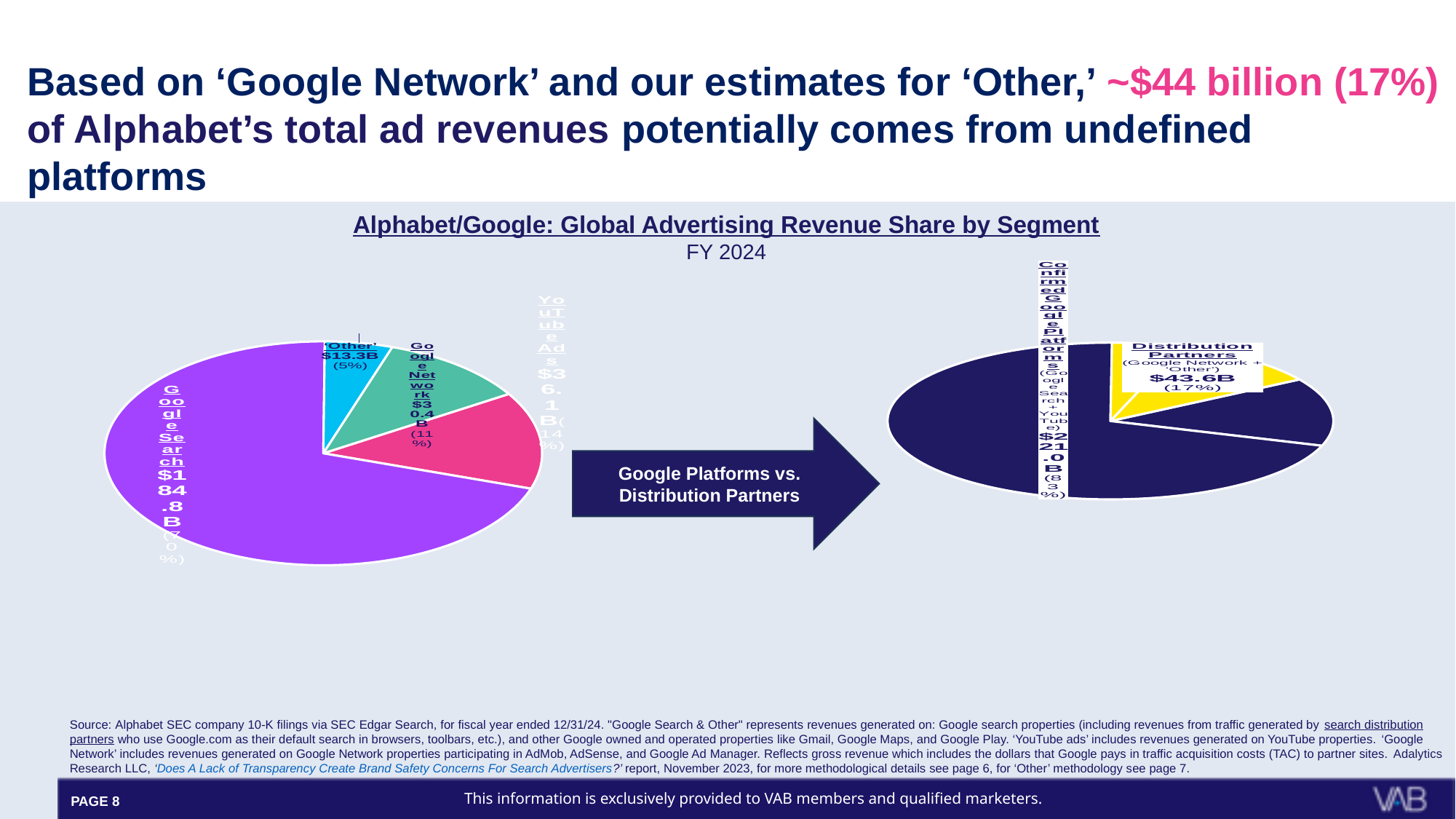
In the right pie chart, what is the revenue value for Distribution Partners? $43.6B How many segments does the left pie chart have? 4 In the left pie chart, what is the revenue value for 'Other'? $13.3B In the left pie chart, what is the revenue value for Google Network? $30.4B In the left pie chart, what is the difference in revenue between Google Network and 'Other'? $17.1B In the left pie chart, which segment is the largest? Google Search In the left pie chart, what share of revenue does YouTube Ads represent? 14% In the right pie chart, what share of revenue do Confirmed Google Platforms represent? 83% In the left pie chart, which segment is the smallest? 'Other' What kind of charts are shown on the slide? Pie charts In the left pie chart, what is the revenue value for Google Search? $184.8B In the left pie chart, what share of revenue does Google Search represent? 70%